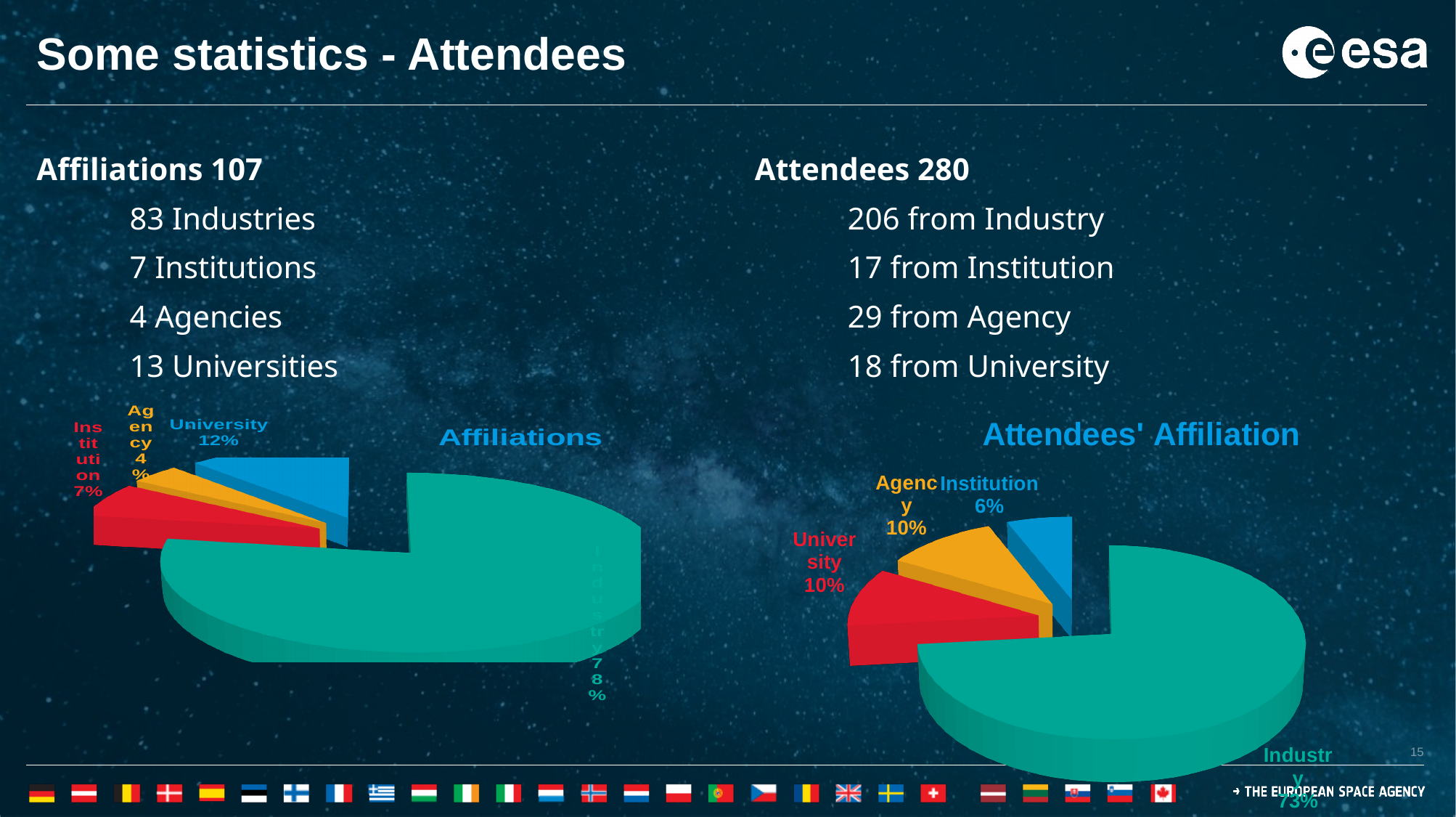
In the Attendees' Affiliation chart, what share does Institution have? 6% What kind of chart is the Affiliations chart? Pie chart In the Affiliations chart, which category has the smallest slice? Agency How many slices does the Attendees' Affiliation chart have? 4 In the Attendees' Affiliation chart, which category has the smallest slice? Institution In the Affiliations chart, what share does Industry have? 78% In the Affiliations chart, what share does University have? 12% In the Affiliations chart, which category has the largest slice? Industry In the Affiliations chart, what is the difference in percentage points between University and Institution? 5